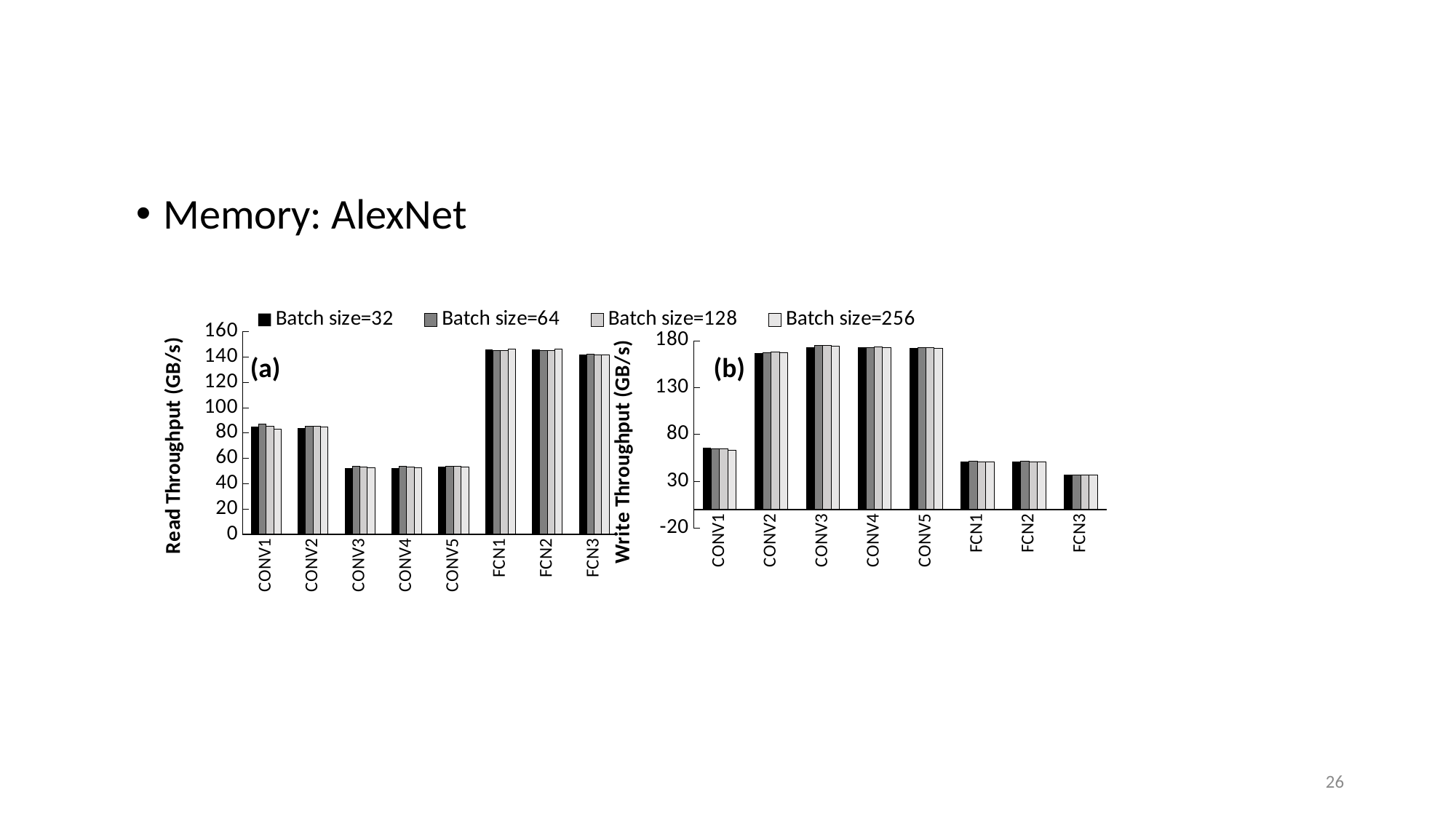
In chart (a), Read Throughput, which is larger for batch size 64: FCN2 or CONV4? FCN2 How many series does the legend list for the charts? 4 In chart (b), Write Throughput, which is larger for batch size 256: CONV2 or FCN1? CONV2 Which legend entry is shown with black bars? Batch size=32 What is the y-axis title of chart (b)? Write Throughput (GB/s) How many categories are shown on the x axis of chart (b), Write Throughput? 8 In chart (b), Write Throughput, which category has the lowest value for batch size 32? FCN3 What kind of chart is chart (a), Read Throughput? Bar chart In chart (a), Read Throughput, is the value for CONV3 at batch size 32 greater or less than 60? less In chart (b), Write Throughput, is the value for CONV1 at batch size 32 greater or less than 80? less In chart (a), Read Throughput, is the value for FCN1 at batch size 32 greater or less than 140? greater